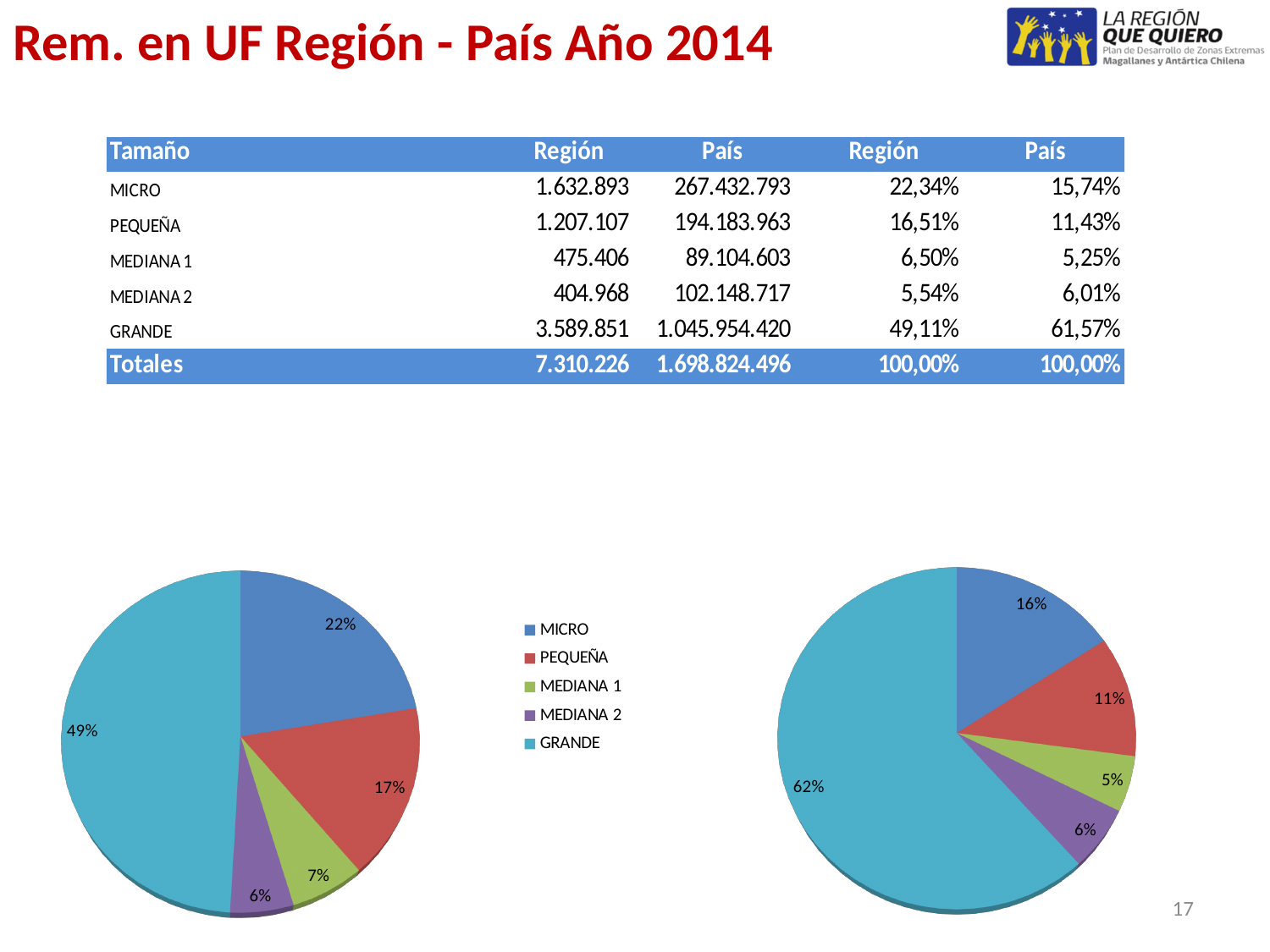
In the right pie chart, what share does the GRANDE slice have? 62% In the left pie chart, which category has the smallest slice? MEDIANA 2 In the left pie chart, what is the difference between the MICRO share and the PEQUEÑA share? 5% In the right pie chart, what share does the PEQUEÑA slice have? 11% In the left pie chart, which category has the largest slice? GRANDE In the left pie chart, what share does the GRANDE slice have? 49% What colour is the GRANDE slice in the pie charts? Teal (light blue) Which is larger: the GRANDE share in the left pie chart or the GRANDE share in the right pie chart? Right pie chart In the right pie chart, which category has the smallest slice? MEDIANA 1 What kind of charts are shown at the bottom of the slide? Pie charts How many categories does the legend between the pie charts list? 5